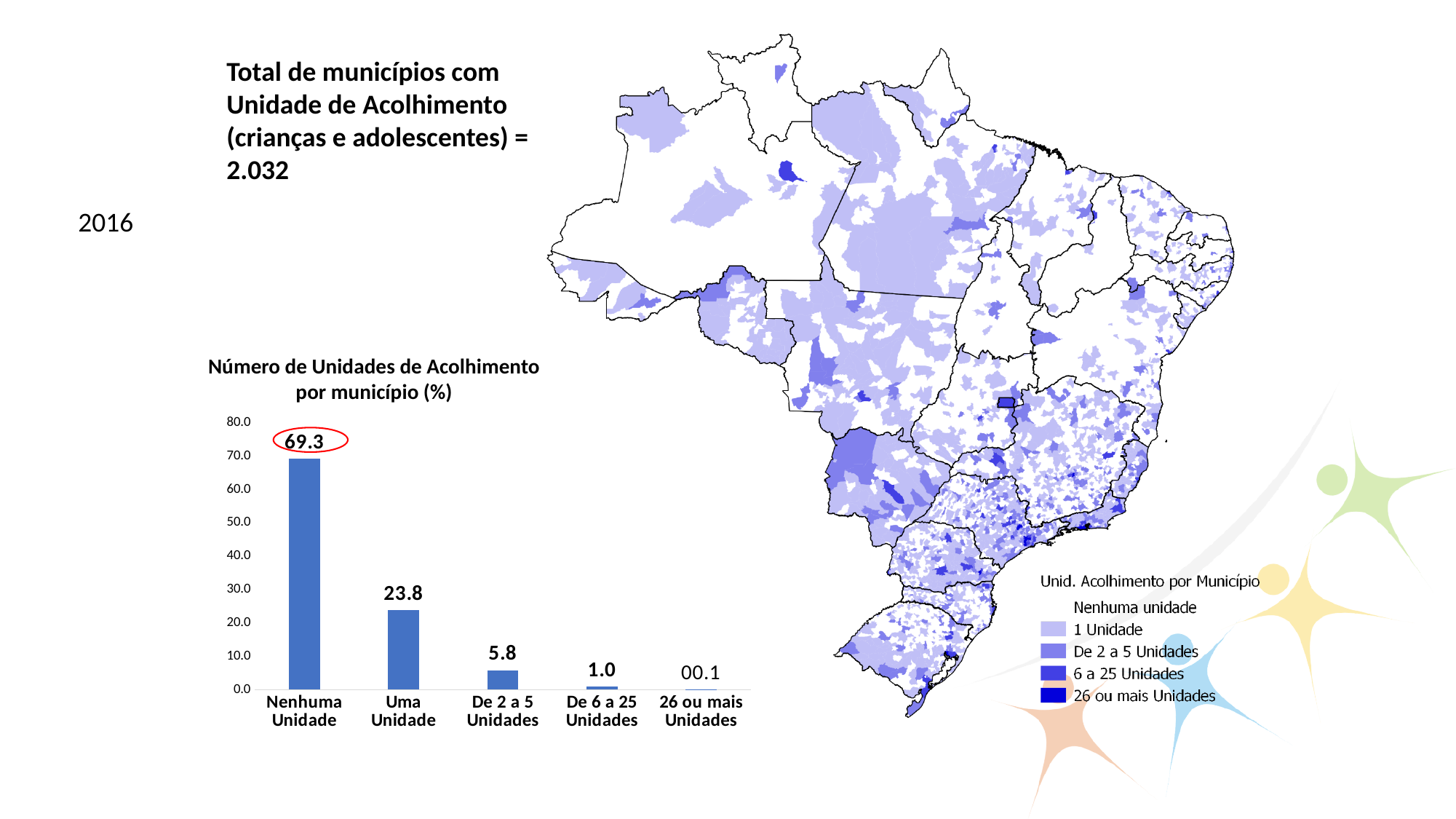
In the chart 'Número de Unidades de Acolhimento por município (%)', what is the value for 'De 2 a 5 Unidades'? 5.8 In the chart 'Número de Unidades de Acolhimento por município (%)', which category has the lowest value? 26 ou mais Unidades How many categories are shown in the chart 'Número de Unidades de Acolhimento por município (%)'? 5 In the chart 'Número de Unidades de Acolhimento por município (%)', which is larger: 'Uma Unidade' or 'De 2 a 5 Unidades'? Uma Unidade In the chart 'Número de Unidades de Acolhimento por município (%)', what is the value for 'Uma Unidade'? 23.8 In the chart 'Número de Unidades de Acolhimento por município (%)', do the values rise or fall from left to right along the x axis? fall In the chart 'Número de Unidades de Acolhimento por município (%)', what is the difference between the values for 'Uma Unidade' and 'De 2 a 5 Unidades'? 18.0 In the chart 'Número de Unidades de Acolhimento por município (%)', what is the value for 'De 6 a 25 Unidades'? 1.0 In the chart 'Número de Unidades de Acolhimento por município (%)', what is the value for 'Nenhuma Unidade'? 69.3 What kind of chart is 'Número de Unidades de Acolhimento por município (%)'? bar chart In the chart 'Número de Unidades de Acolhimento por município (%)', what is the difference between the values for 'Nenhuma Unidade' and 'Uma Unidade'? 45.5 In the chart 'Número de Unidades de Acolhimento por município (%)', which category has the highest value? Nenhuma Unidade